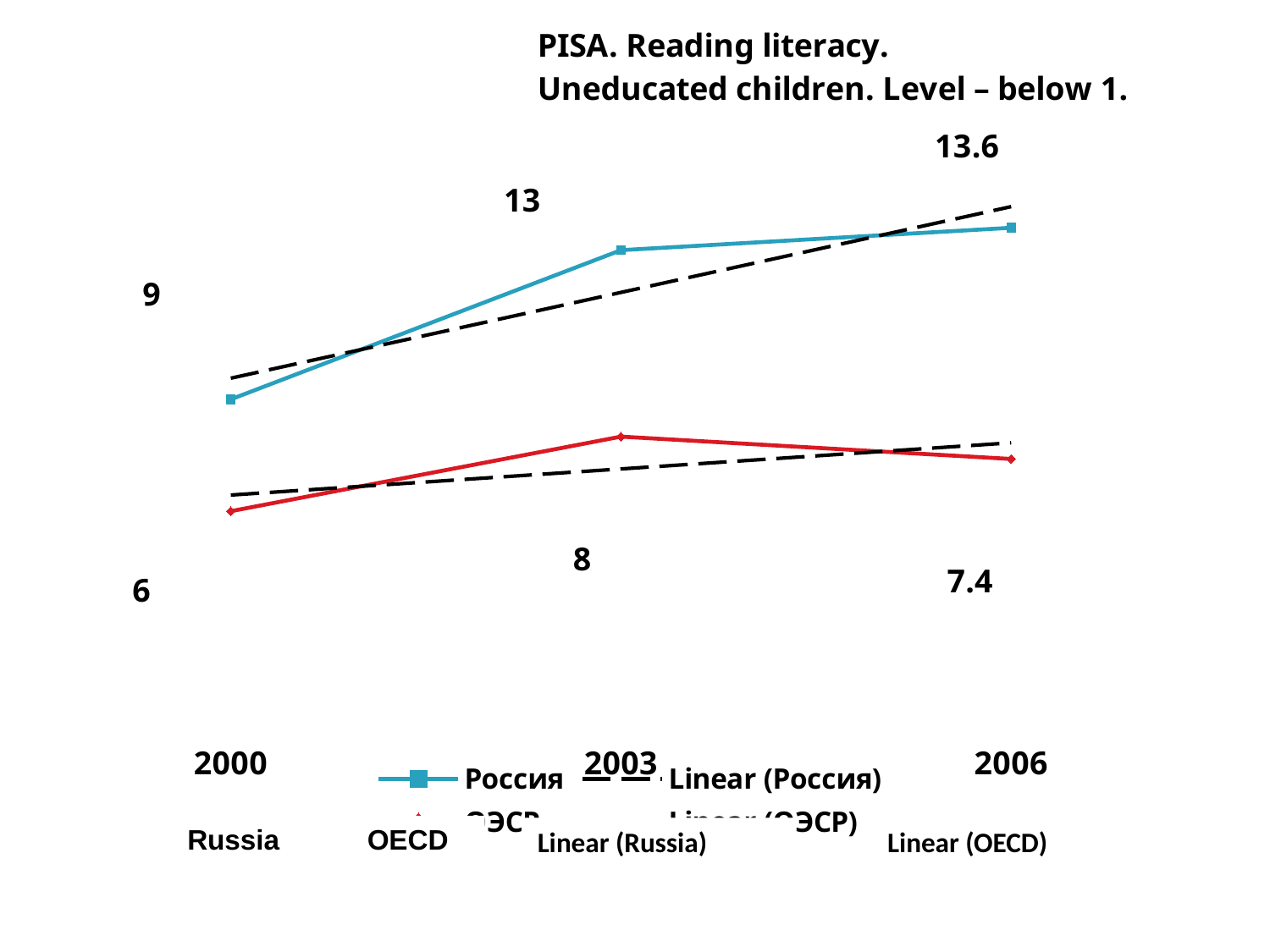
What is the value for Russia in 2000? 9 What is the difference between the Russia and OECD values in 2006? 6.2 What is the value for OECD in 2000? 6 Which series has the larger value in 2003, Russia or OECD? Russia What is the value for OECD in 2006? 7.4 In which year is the Russia series at its highest? 2006 By how much did the Russia value increase from 2000 to 2003? 4 Does the OECD value rise or fall from 2003 to 2006? Fall What is the value for Russia in 2003? 13 How many years are shown on the x axis? 3 What kind of chart is shown on the slide? Line chart In which year is the OECD series at its highest? 2003